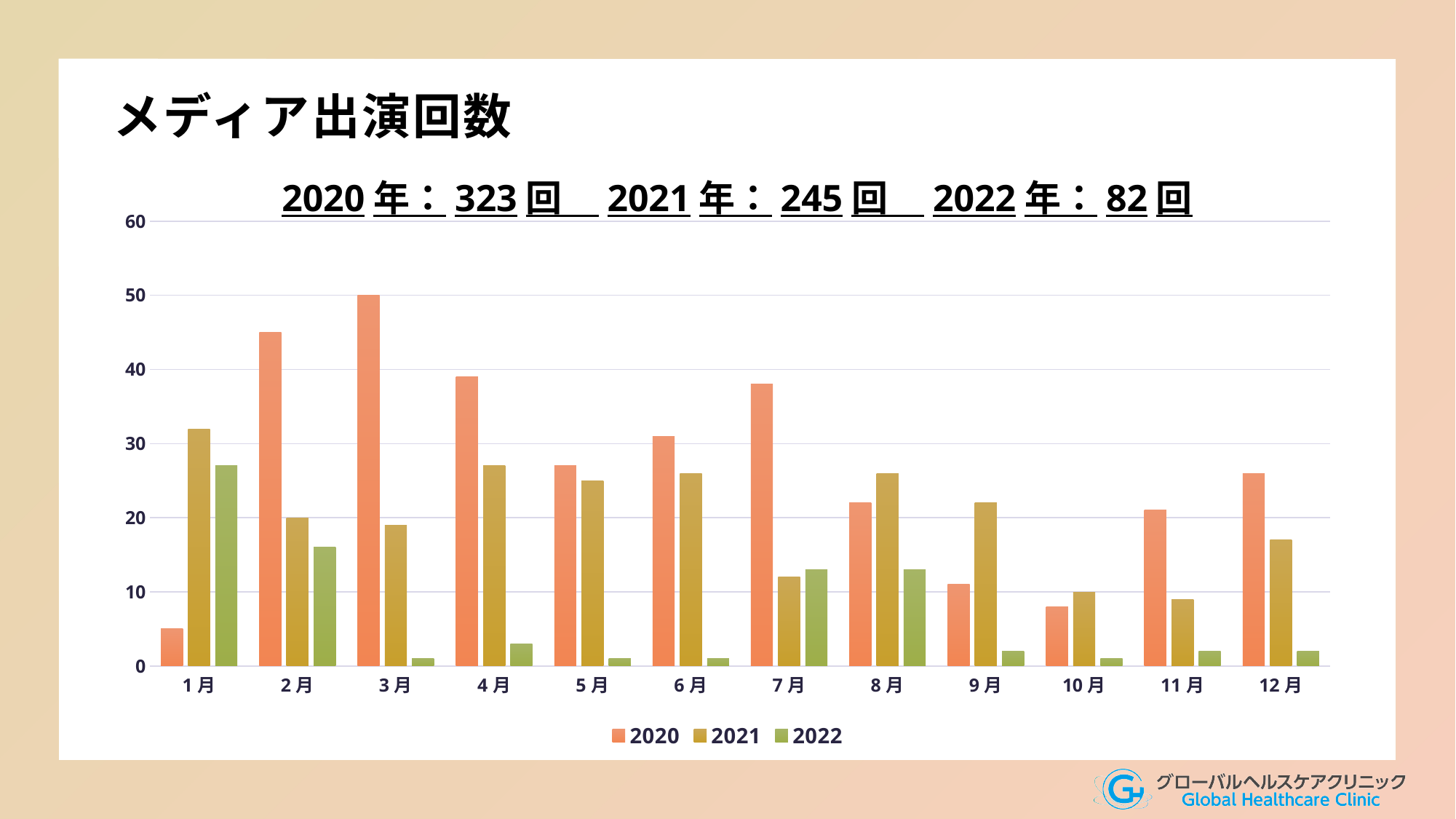
Is the 2022 value for 7月 greater or less than 10? greater What is the difference between the annual totals for 2020 (323回) and 2021 (245回) shown above the chart? 78回 Is the 2020 value for 4月 greater or less than 30? greater How many months are shown on the x axis? 12 In which month is the 2020 value lowest? 1月 For 1月, which is larger: the 2020 value or the 2021 value? 2021 In which month is the 2021 value highest? 1月 According to the text above the chart, what is the annual total for 2022? 82回 How many series does the legend list? 3 What is the 2020 value for 3月? 50 In which month is the 2020 value highest? 3月 What kind of chart is shown on the slide? bar chart